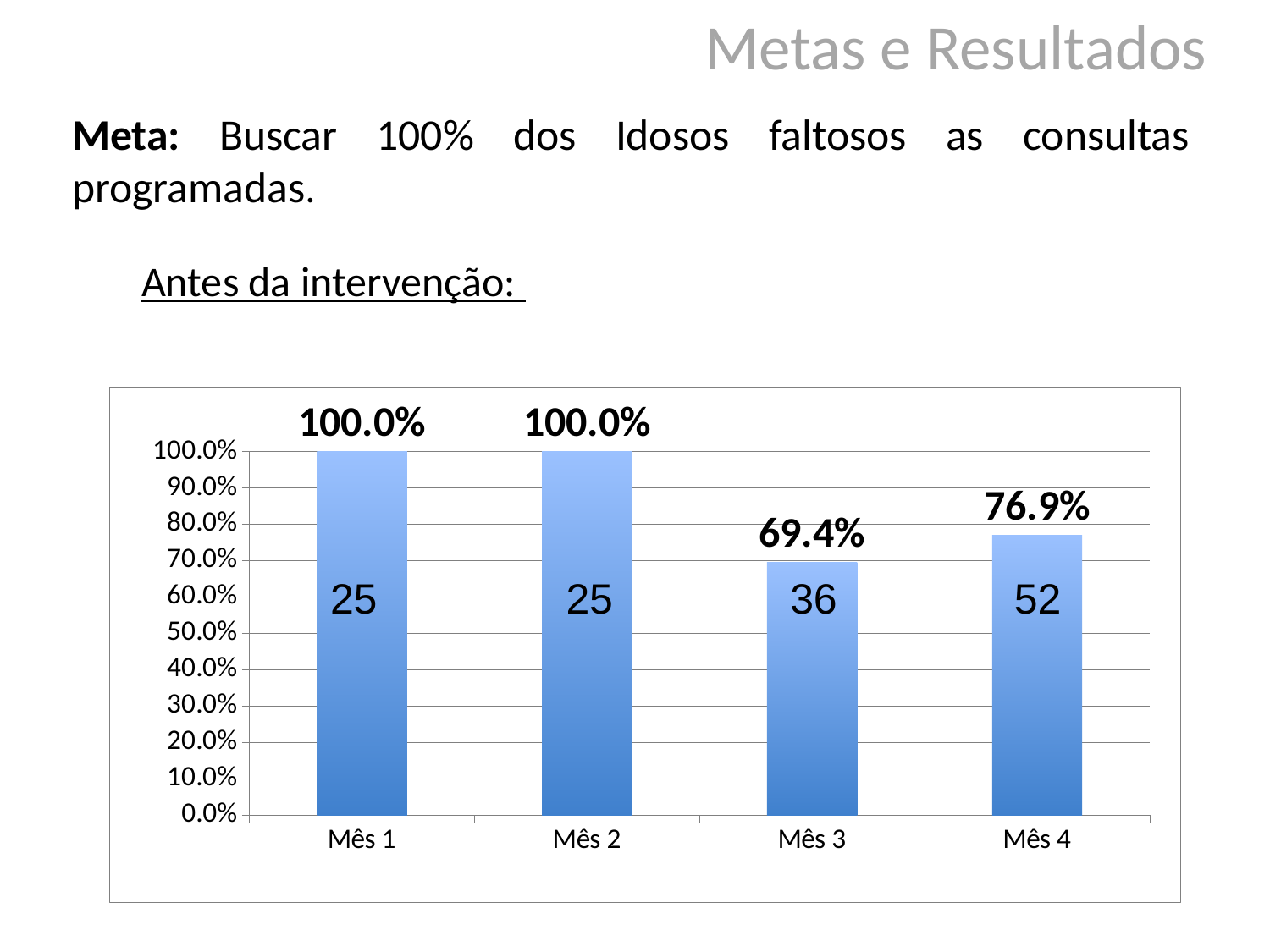
What percentage is shown for Mês 4? 76.9% Which has a higher percentage, Mês 3 or Mês 4? Mês 4 Is the value for Mês 3 greater or less than 80.0%? less Which month has the lowest percentage? Mês 3 What number is printed inside the bar for Mês 4? 52 What is the difference in percentage between Mês 1 and Mês 4? 23.1% What kind of chart is shown on the slide? bar chart What number is printed inside the bar for Mês 3? 36 What is the highest value shown on the y axis? 100.0% What percentage is shown for Mês 3? 69.4% What is the difference in percentage between Mês 4 and Mês 3? 7.5% How many months are shown on the x axis? 4